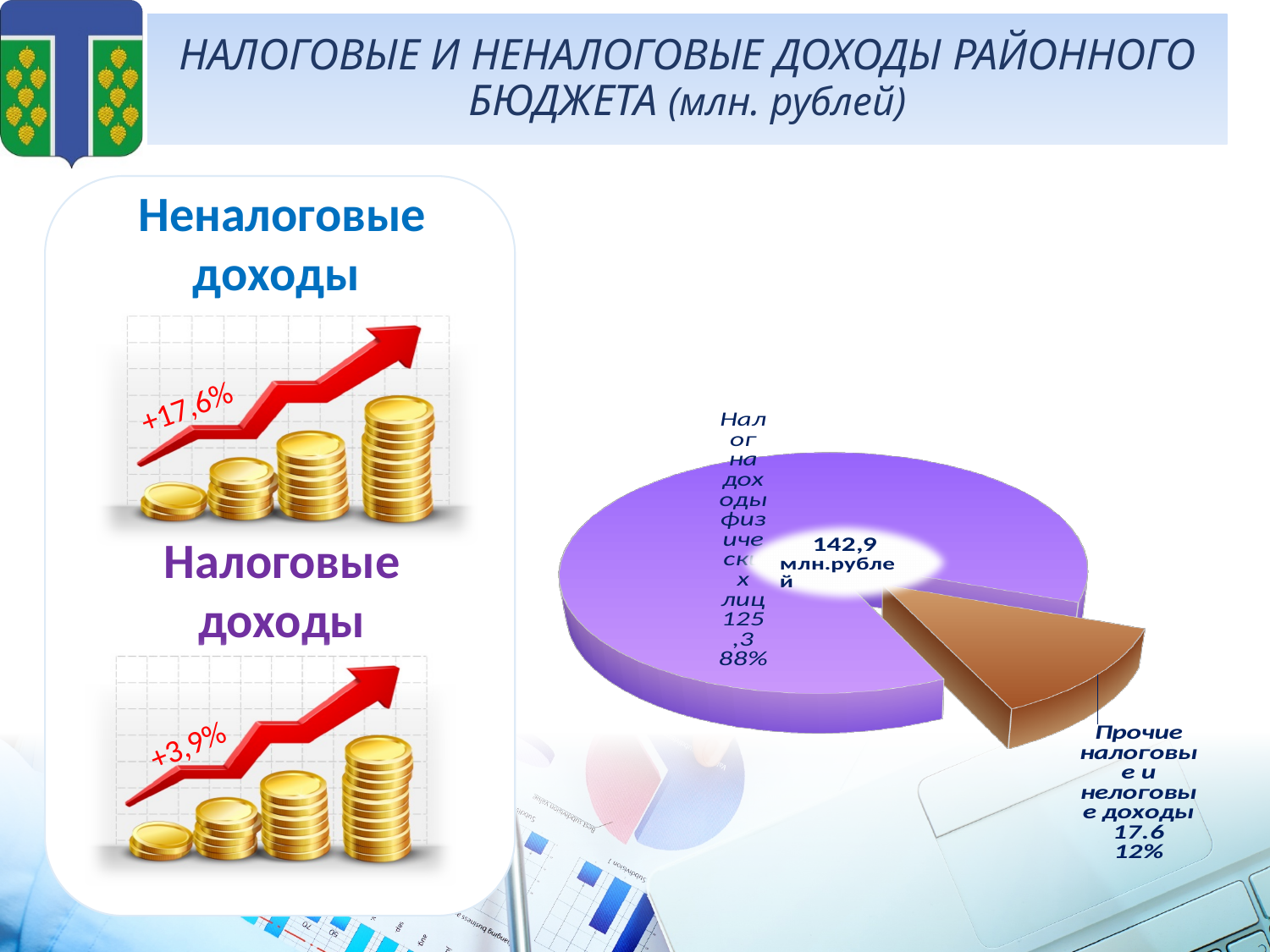
What share of the pie does "Налог на доходы физических лиц" represent? 88% What is the difference between the values of the two slices in the pie chart (125,3 and 17.6)? 107,7 Which slice of the pie chart is the largest? Налог на доходы физических лиц Which is larger in the pie chart: "Налог на доходы физических лиц" or "Прочие налоговые и неналоговые доходы"? Налог на доходы физических лиц What is the value shown for the slice "Налог на доходы физических лиц" in the pie chart? 125,3 What kind of chart is shown on the right side of the slide? pie chart What is the value shown for the slice "Прочие налоговые и неналоговые доходы" in the pie chart? 17.6 What share of the pie does "Прочие налоговые и неналоговые доходы" represent? 12% What colour is the slice for "Прочие налоговые и неналоговые доходы" in the pie chart? brown Which slice of the pie chart is the smallest? Прочие налоговые и неналоговые доходы How many slices does the pie chart have? 2 What total value is printed in the centre of the pie chart? 142,9 млн.рублей